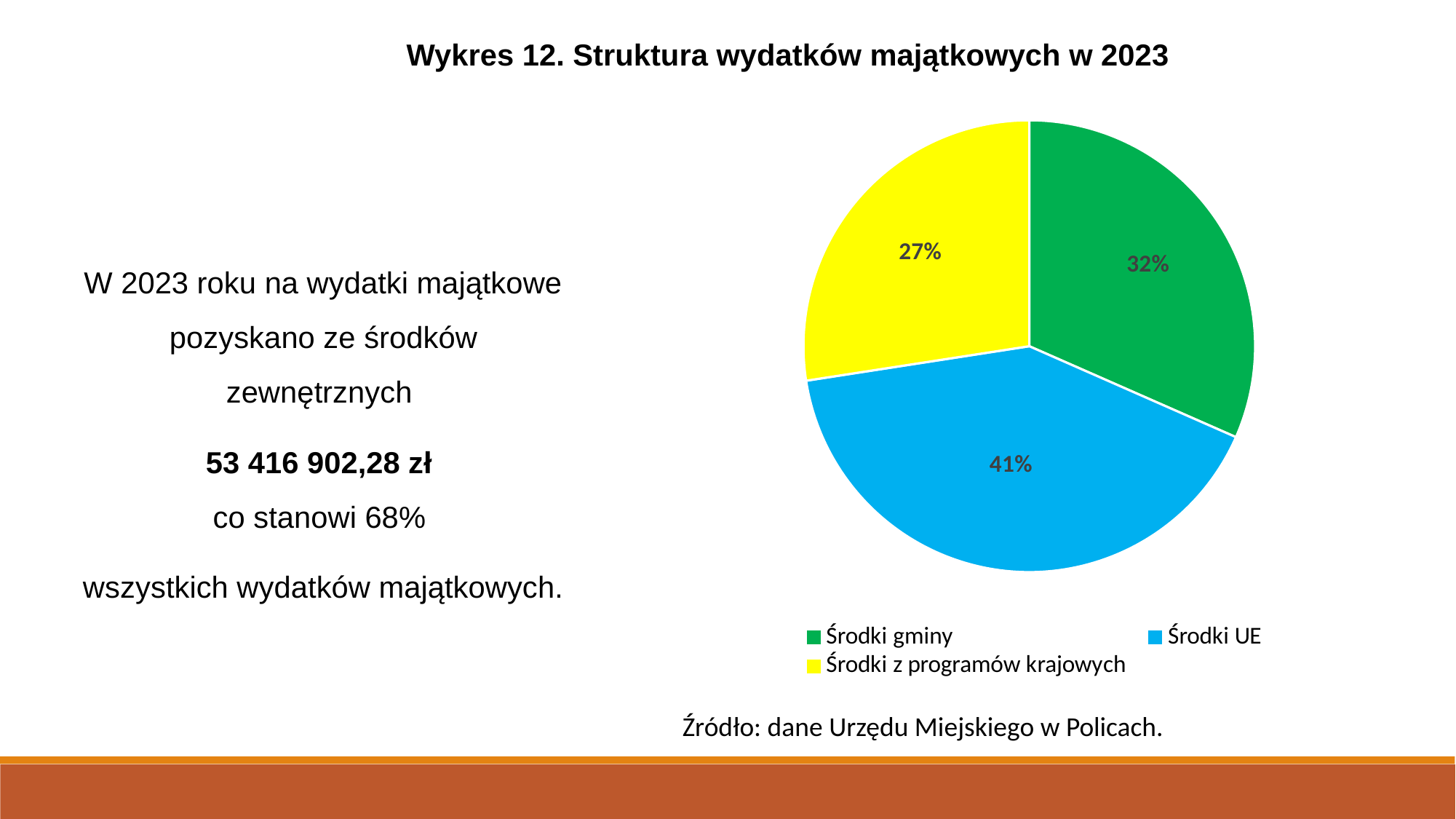
What share of the pie does Środki gminy represent? 32% Which is larger: the Środki gminy slice or the Środki z programów krajowych slice? Środki gminy What is the title of the chart? Wykres 12. Struktura wydatków majątkowych w 2023 What is the difference in percentage points between the Środki UE slice and the Środki gminy slice? 9 Which category has the largest slice of the pie? Środki UE How many slices does the pie chart have? 3 What is the difference in percentage points between the Środki gminy slice and the Środki z programów krajowych slice? 5 What share of the pie does Środki UE represent? 41% What kind of chart is shown on the slide? Pie chart What share of the pie does Środki z programów krajowych represent? 27% What colour is the Środki UE slice? Blue Which category has the smallest slice of the pie? Środki z programów krajowych